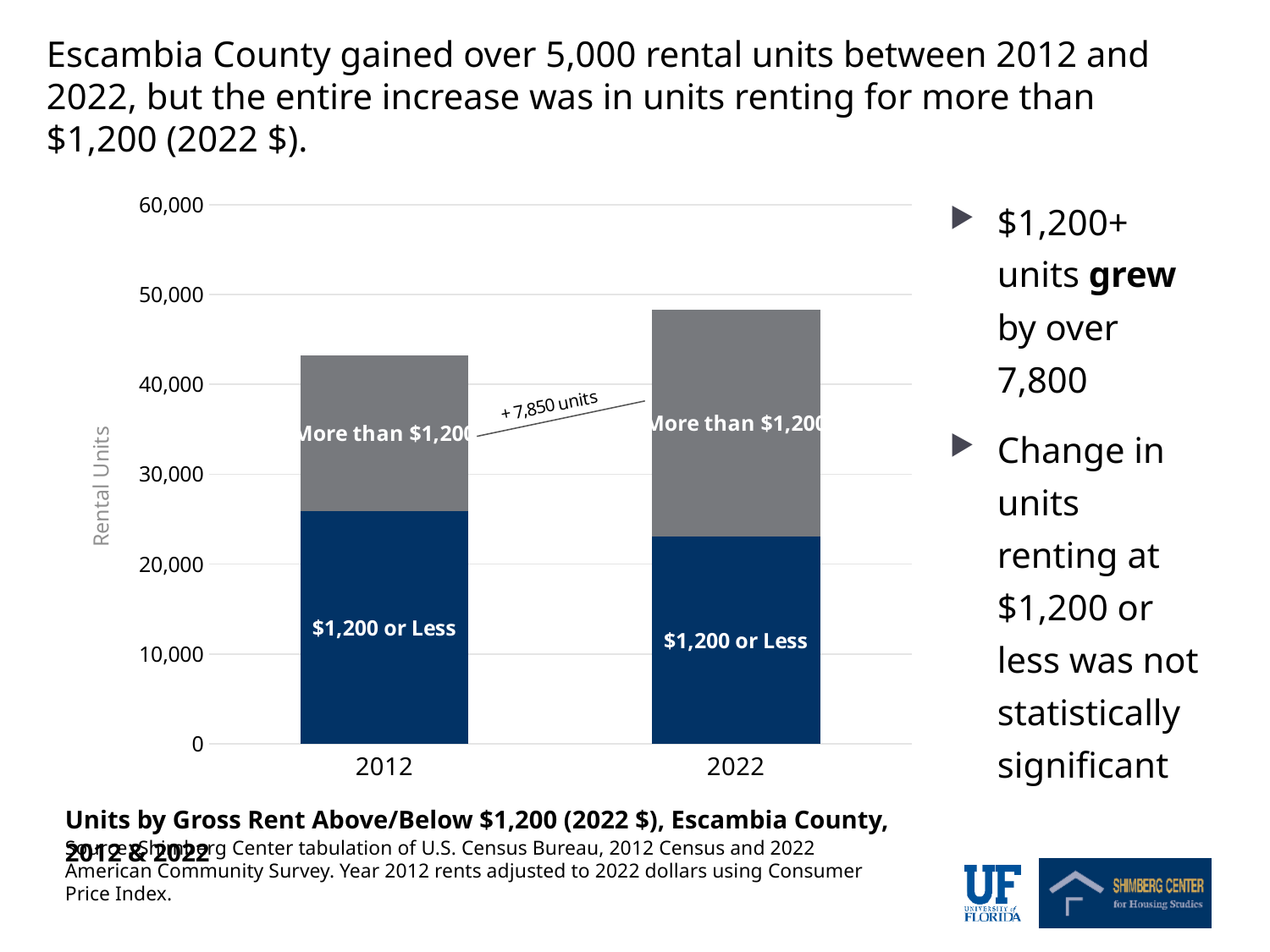
Is the total number of rental units in 2012 greater or less than 40,000? greater Which year has more units renting for $1,200 or less, 2012 or 2022? 2012 How many years (categories) are shown on the x axis of the chart? 2 According to the annotation on the chart, by how many units did the 'More than $1,200' segment change between 2012 and 2022? + 7,850 units How many rent series are stacked in each bar of the chart? 2 Does the total number of rental units rise or fall from 2012 to 2022? rise Is the total number of rental units in 2022 greater or less than 50,000? less What kind of chart is shown on the slide? Stacked bar chart Is the number of units renting for $1,200 or less in 2022 greater or less than 30,000? less Which year has the larger total number of rental units, 2012 or 2022? 2022 What is the title of the y axis on the chart? Rental Units